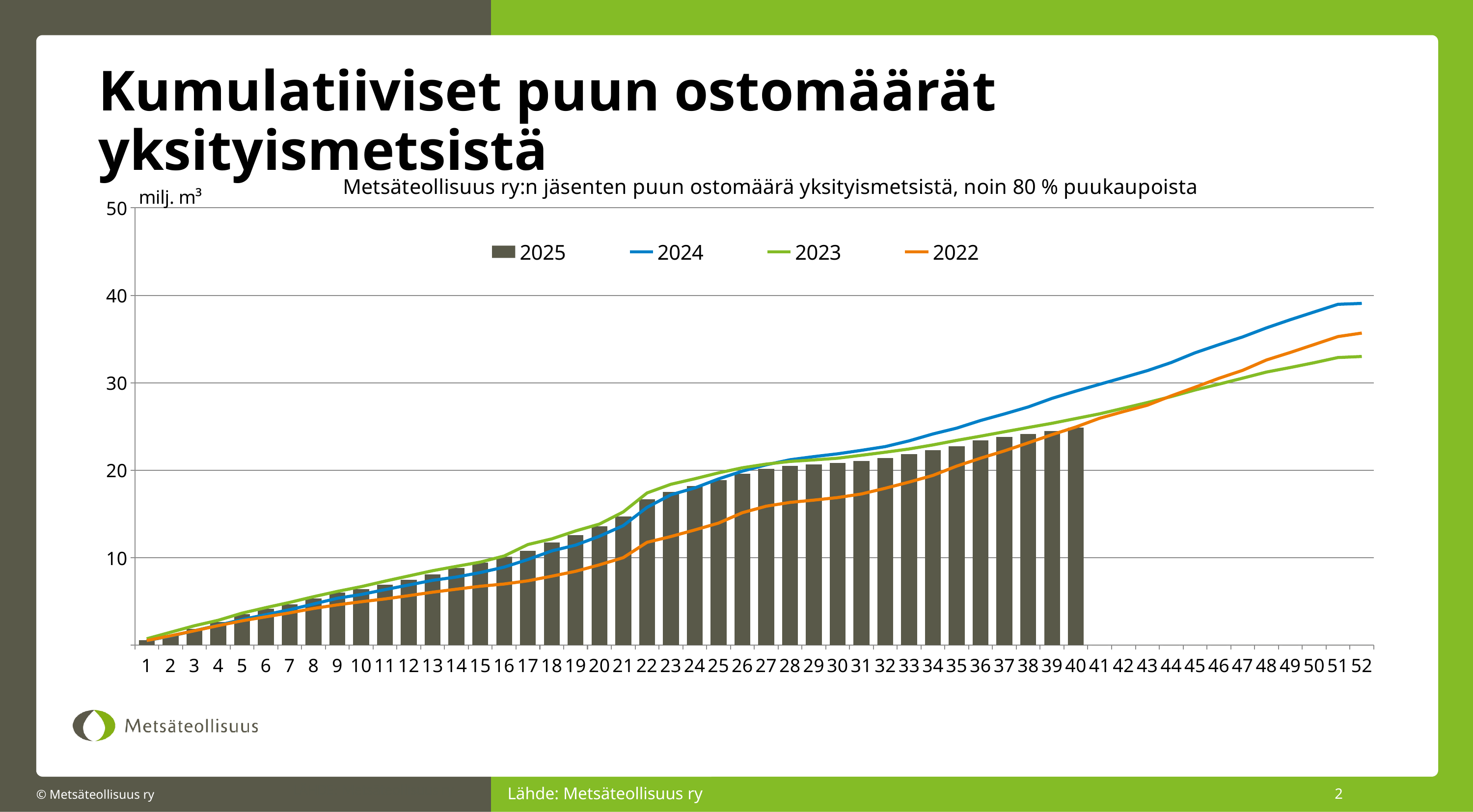
How many weeks are labelled on the x axis? 52 What unit is shown on the y axis? milj. m³ What kind of chart is this? Combined bar and line chart Which series has the highest value at week 52? 2024 Is the value for the 2025 bar at week 40 greater or less than 30? less At week 40, which is larger: the 2024 line or the 2025 bar? 2024 Do the values for the 2024 line rise or fall along the x axis? Rise Which series has the lowest value at week 30? 2022 Is the value for 2024 at week 52 greater or less than 30? greater How many series does the legend list? 4 Up to which week do the 2025 bars extend? 40 Which series has the lowest value at week 52? 2023